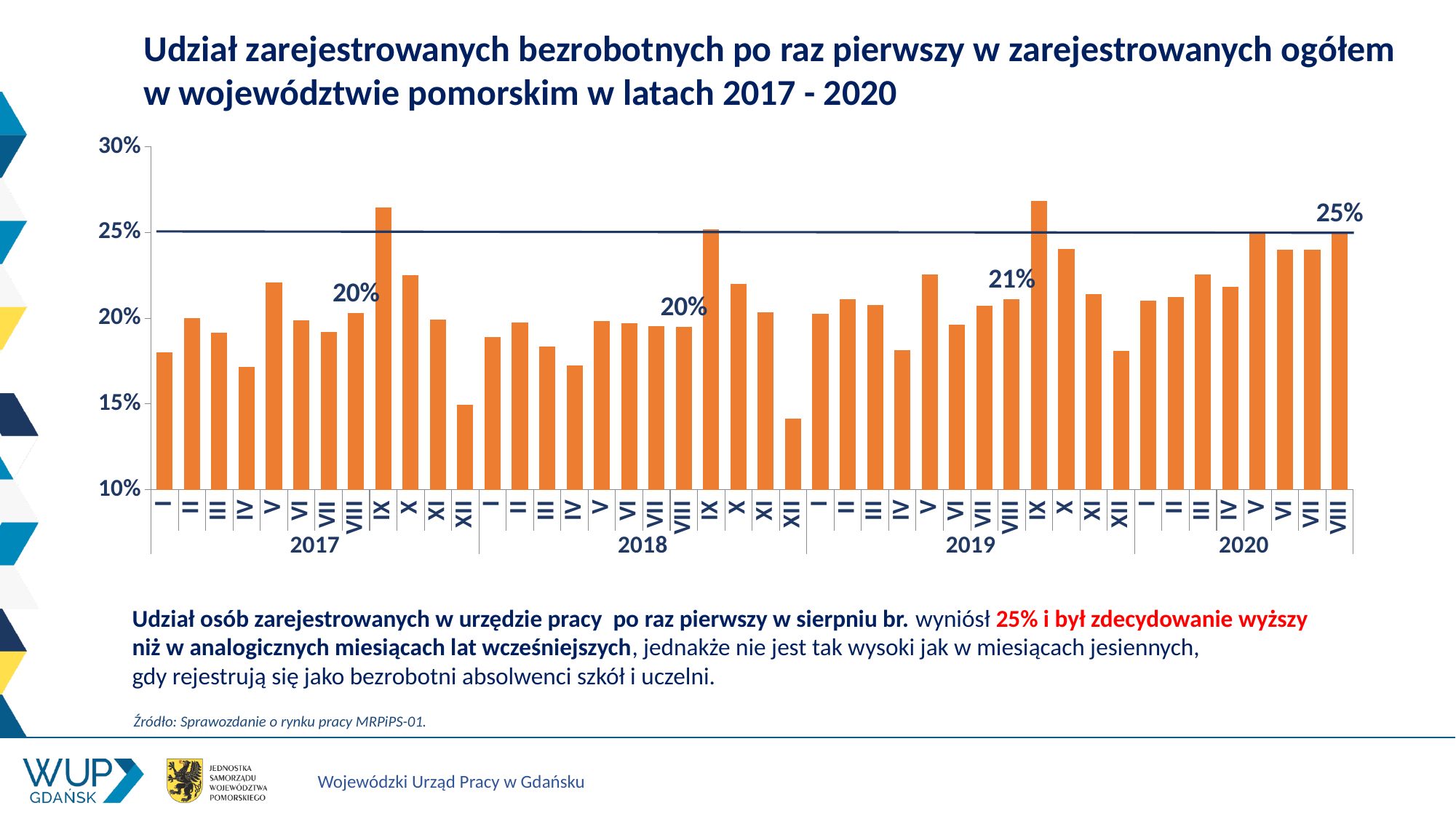
By how many percentage points is the labelled value for VIII 2020 higher than the labelled value for VIII 2019? 4 percentage points What value is labelled for month VIII of 2019? 21% What kind of chart is shown on the slide? bar chart What value is labelled for month VIII of 2020? 25% Is the value for XII 2018 greater or less than 15%? less Which month has the lowest bar in the chart? XII 2018 How many monthly bars are plotted in the chart? 44 What value is labelled for month VIII of 2018? 20% At what level is the horizontal reference line drawn across the chart? 25% Is the value for IX 2017 greater or less than 25%? greater What value is labelled for month VIII of 2017? 20% Which is larger, the labelled value for VIII 2020 or for VIII 2018? VIII 2020